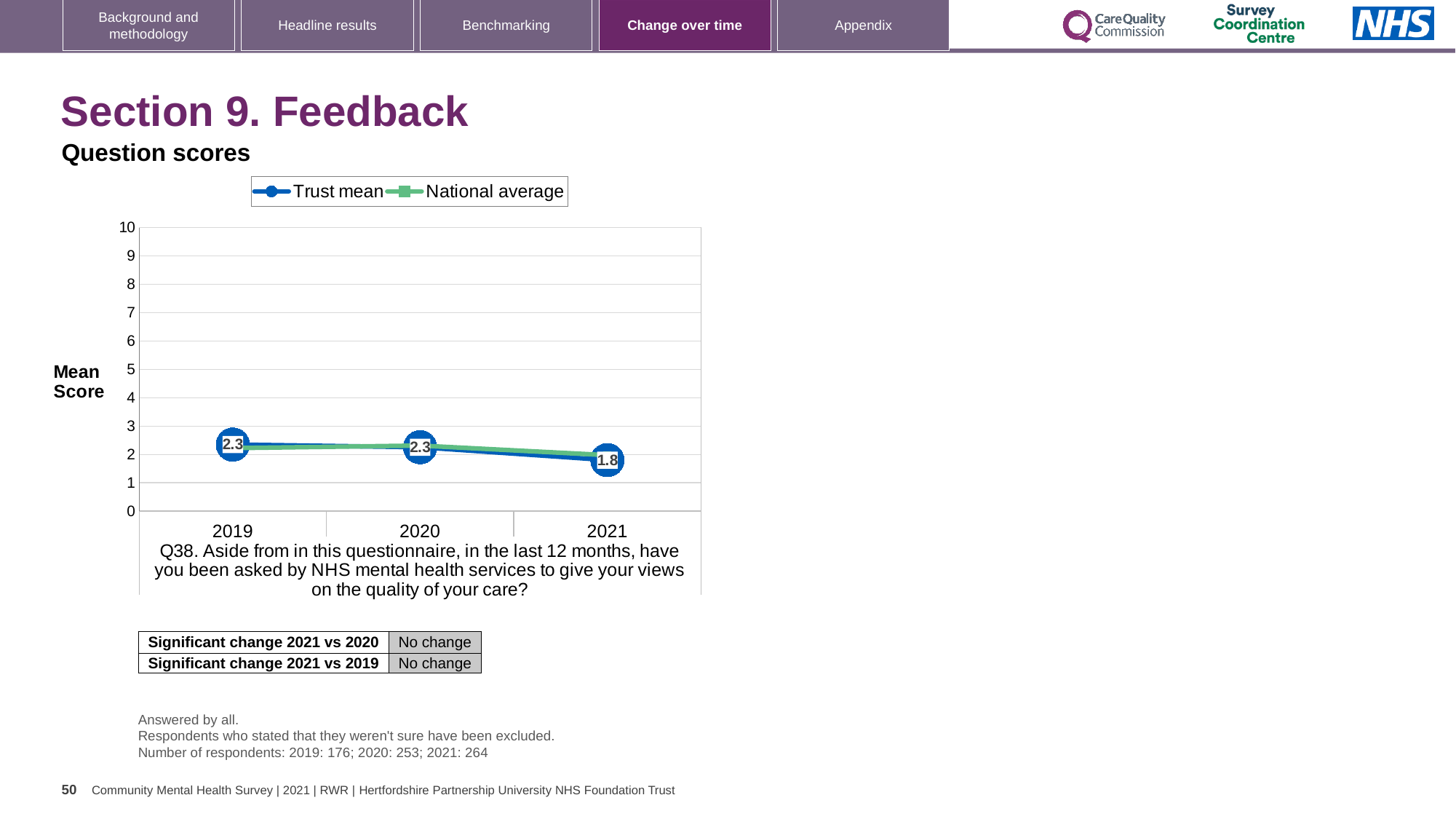
What is the Trust mean for 2021? 1.8 Is the National average for 2021 greater or less than 3? less Which is larger, the Trust mean for 2019 or for 2021? 2019 What kind of chart is shown on the slide? line chart How many years are plotted on the x axis? 3 What is the difference between the Trust mean in 2020 and in 2021? 0.5 How many series does the legend list? 2 What is the Trust mean for 2020? 2.3 Does the Trust mean rise or fall from 2020 to 2021? fall In which year is the Trust mean lowest? 2021 What is the label on the y axis of the chart? Mean Score What is the Trust mean for 2019? 2.3